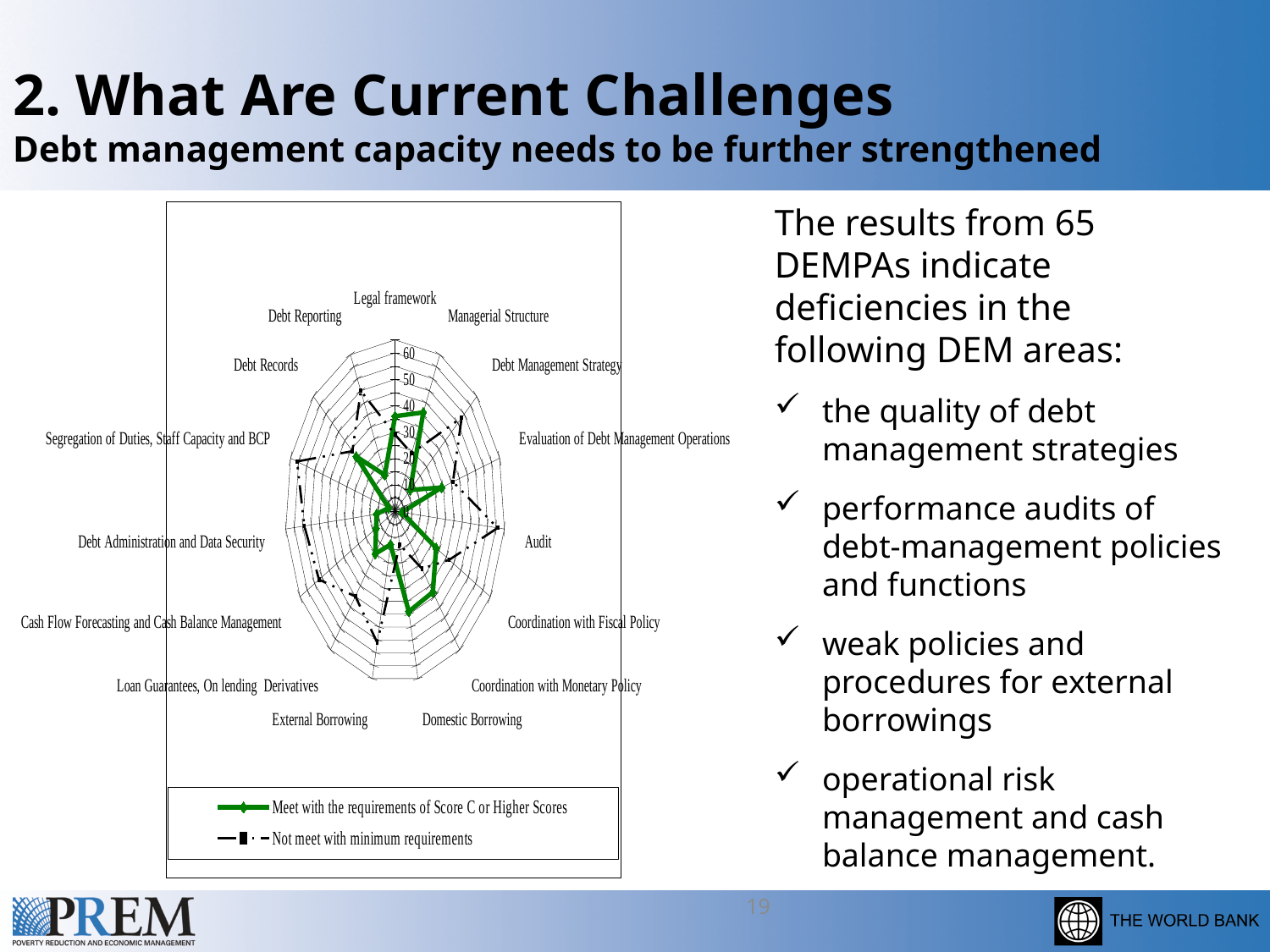
Is the value of the 'Meet with the requirements of Score C or Higher Scores' series for Audit greater or less than 30? less For Audit, which series has the larger value: 'Meet with the requirements of Score C or Higher Scores' or 'Not meet with minimum requirements'? Not meet with minimum requirements How many categories (axes) does the radar chart have? 15 For Debt Management Strategy, which series has the larger value: 'Meet with the requirements of Score C or Higher Scores' or 'Not meet with minimum requirements'? Not meet with minimum requirements Is the value of the 'Not meet with minimum requirements' series for Audit greater or less than 30? greater Is the value of the 'Meet with the requirements of Score C or Higher Scores' series for Debt Management Strategy greater or less than 30? less What kind of chart is shown on the slide? Radar chart How many series does the chart legend list? 2 Which series is drawn with the solid green line? Meet with the requirements of Score C or Higher Scores What is the highest tick value shown on the radar chart's axis? 60